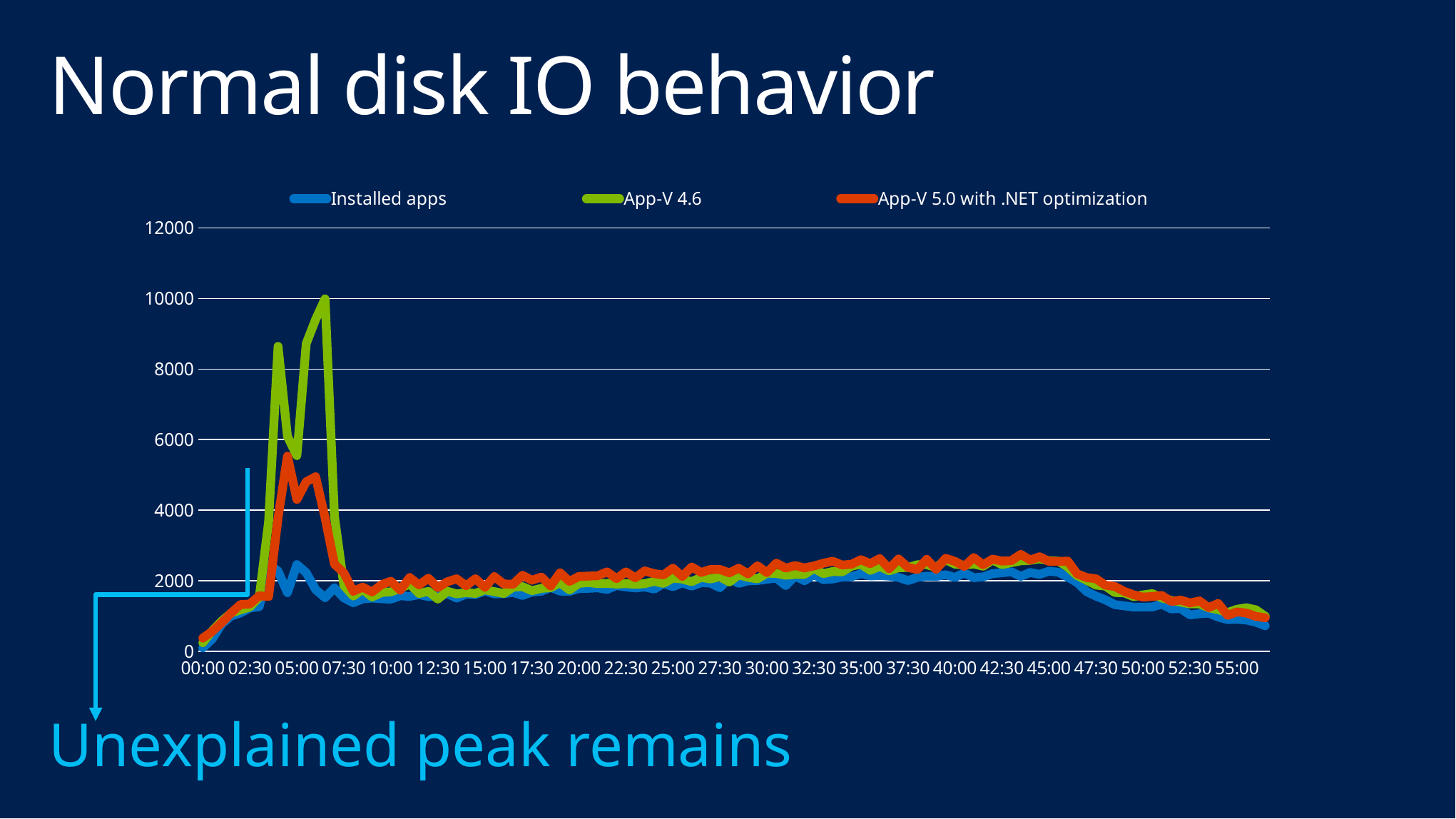
Is the peak value for Installed apps greater or less than 4000? less Is the value for App-V 4.6 at 55:00 greater or less than 2000? less Is the peak value for App-V 4.6 greater or less than 8000? greater Which series reaches the highest peak in the chart? App-V 4.6 How many time labels are shown on the x axis? 23 Which series has the lowest peak around the 05:00 mark? Installed apps Which series is drawn in green in the chart? App-V 4.6 What kind of chart is shown on the slide? line chart How many series does the legend list? 3 What is the title of the slide containing the chart? Normal disk IO behavior Do the values for all three series rise or fall between 45:00 and 55:00? fall